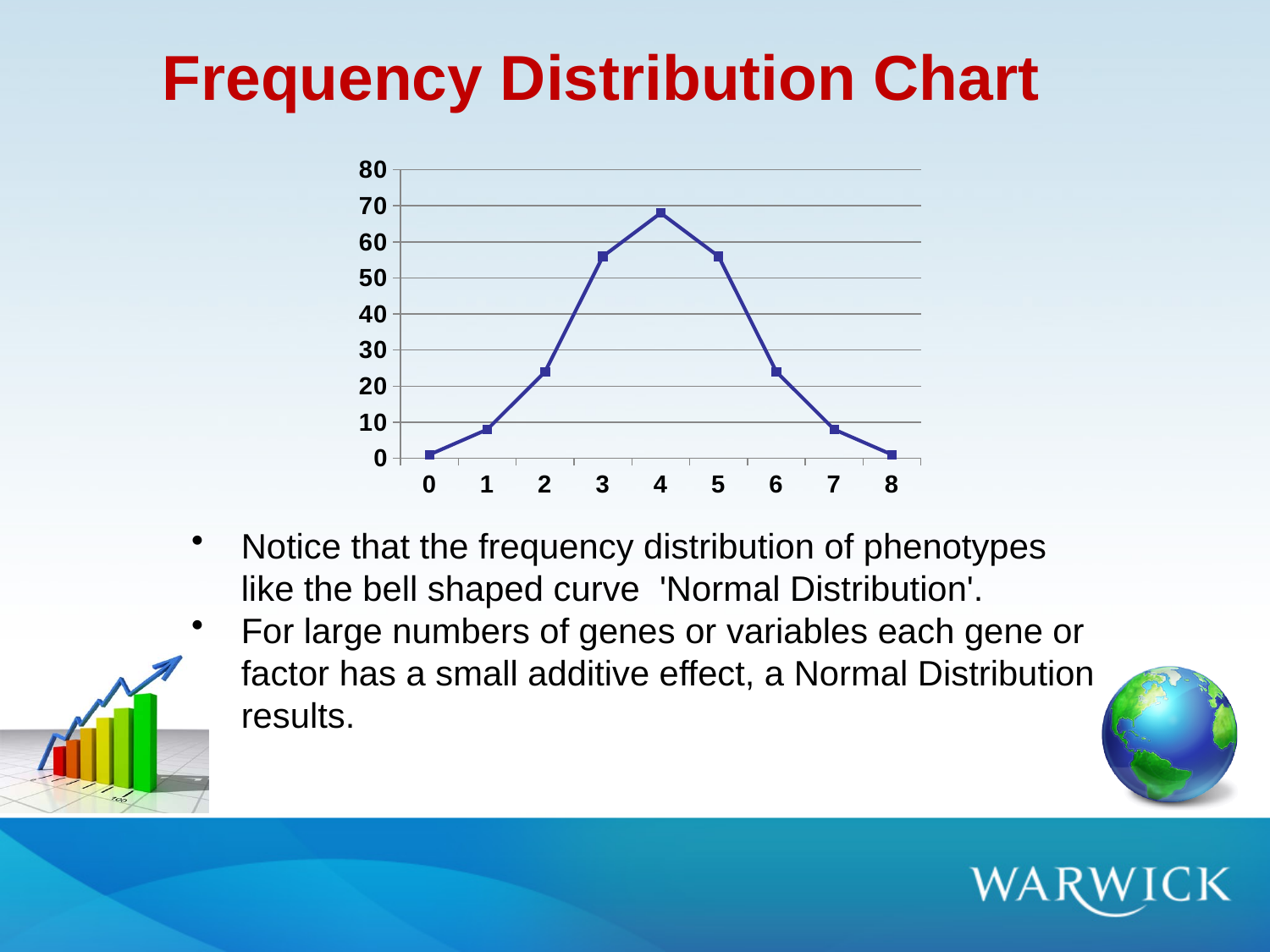
Is the value at x = 4 greater or less than 60? greater Which has the larger value, x = 3 or x = 4? 4 Is the value at x = 2 greater or less than 20? greater What kind of chart is shown on the slide? line chart How many data points are plotted on the line? 9 Which x-axis category has the highest value? 4 Is the value at x = 3 greater or less than 50? greater What is the highest value shown on the y-axis? 80 Do the values rise or fall as x goes from 0 to 4? rise Do the values rise or fall as x goes from 4 to 8? fall